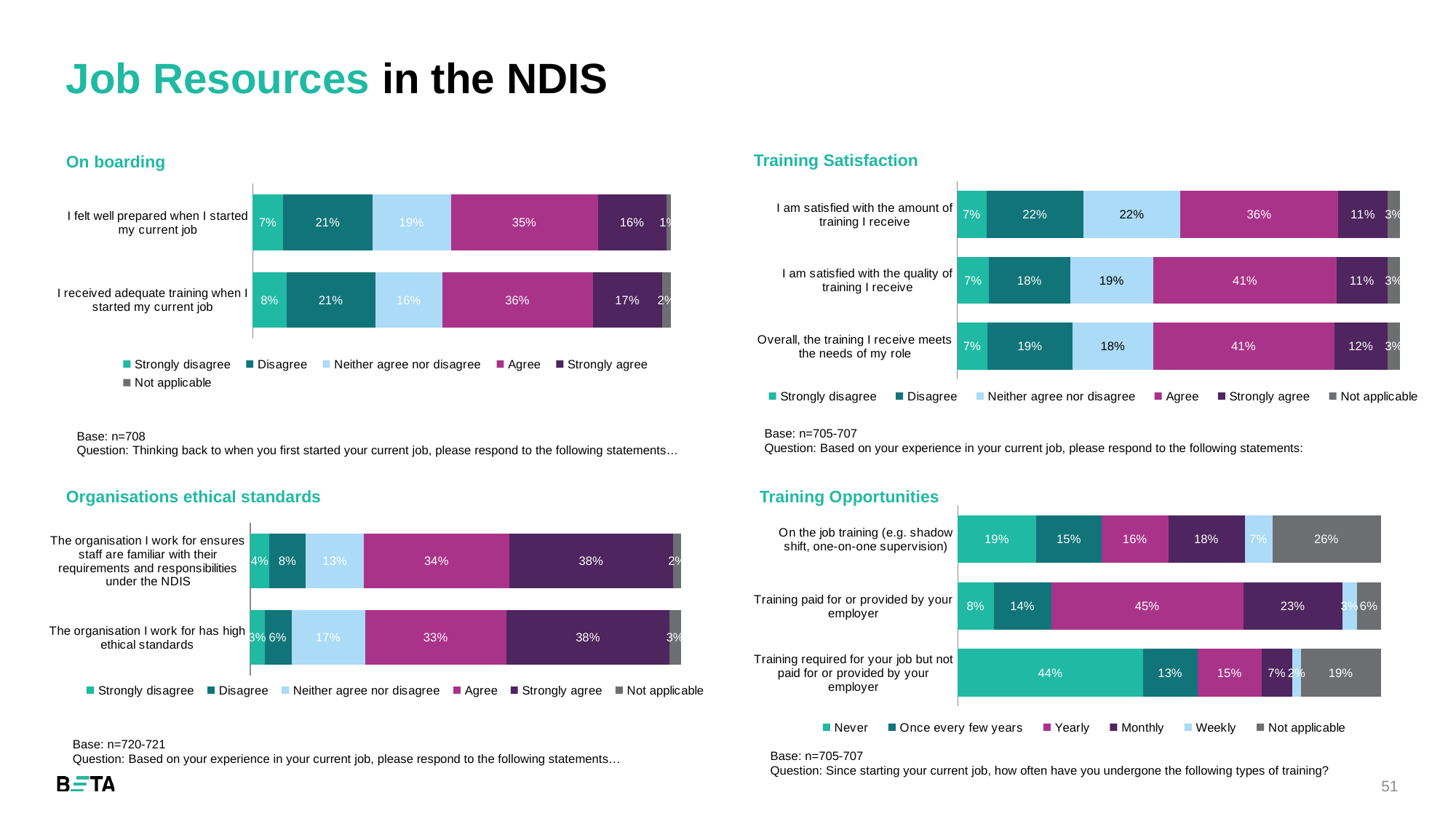
How many series does the legend of the Training Opportunities chart list? 6 In the Training Opportunities chart, which type of training has the highest 'Not applicable' percentage? On the job training (e.g. shadow shift, one-on-one supervision) In the Organisations ethical standards chart, what percentage strongly agree that 'The organisation I work for has high ethical standards'? 38% How many statements are shown in the Training Satisfaction chart? 3 What kind of chart is the On boarding chart? Stacked bar chart In the Training Satisfaction chart, what is the difference in the Disagree percentage between 'I am satisfied with the amount of training I receive' and 'I am satisfied with the quality of training I receive'? 4 percentage points In the Training Satisfaction chart, what percentage agree with 'I am satisfied with the quality of training I receive'? 41% In the On boarding chart, what percentage neither agree nor disagree with 'I felt well prepared when I started my current job'? 19% In the Training Opportunities chart, which has the larger 'Yearly' share: 'On the job training' or 'Training paid for or provided by your employer'? Training paid for or provided by your employer In the Training Opportunities chart, what percentage answered 'Never' for 'Training required for your job but not paid for or provided by your employer'? 44% In the On boarding chart, what percentage of respondents agree with 'I received adequate training when I started my current job'? 36% What is the title of the chart in the bottom-left of the slide? Organisations ethical standards